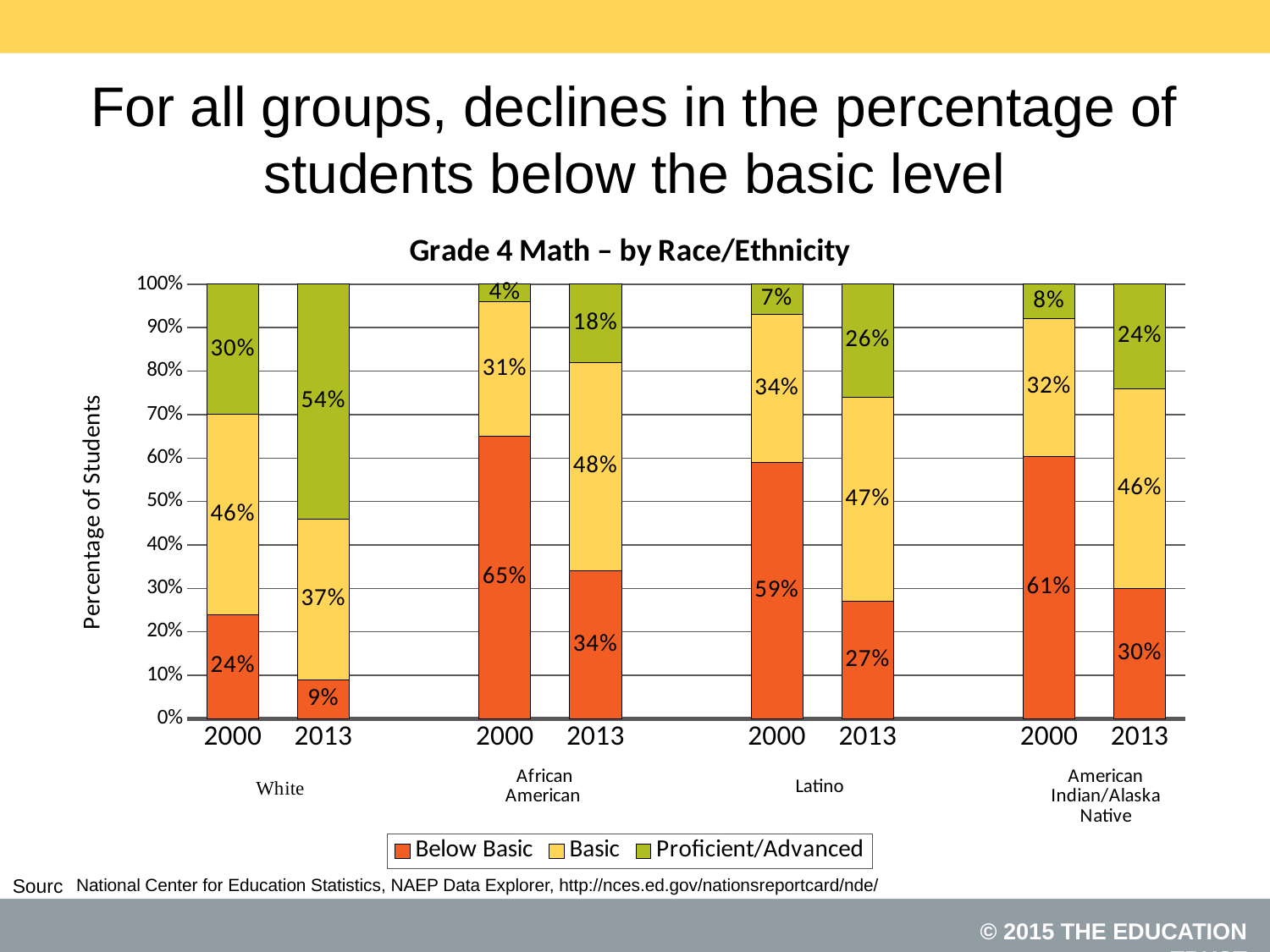
Which is larger: the Proficient/Advanced share for White students in 2013 or for Latino students in 2013? White students in 2013 Which group had the lowest Below Basic percentage in 2013? White Which group had the highest Below Basic percentage in 2000? African American What is the title of the chart? Grade 4 Math – by Race/Ethnicity How many race/ethnicity groups are shown on the chart? 4 What percentage of African American students were Proficient/Advanced in 2013? 18% What percentage of White students were Below Basic in 2000? 24% What percentage of American Indian/Alaska Native students were Below Basic in 2000? 61% By how many percentage points did the Below Basic share for Latino students fall from 2000 to 2013? 32 percentage points How many series does the legend list? 3 What percentage of Latino students were Basic in 2013? 47% What kind of chart is shown on the slide? Stacked bar chart